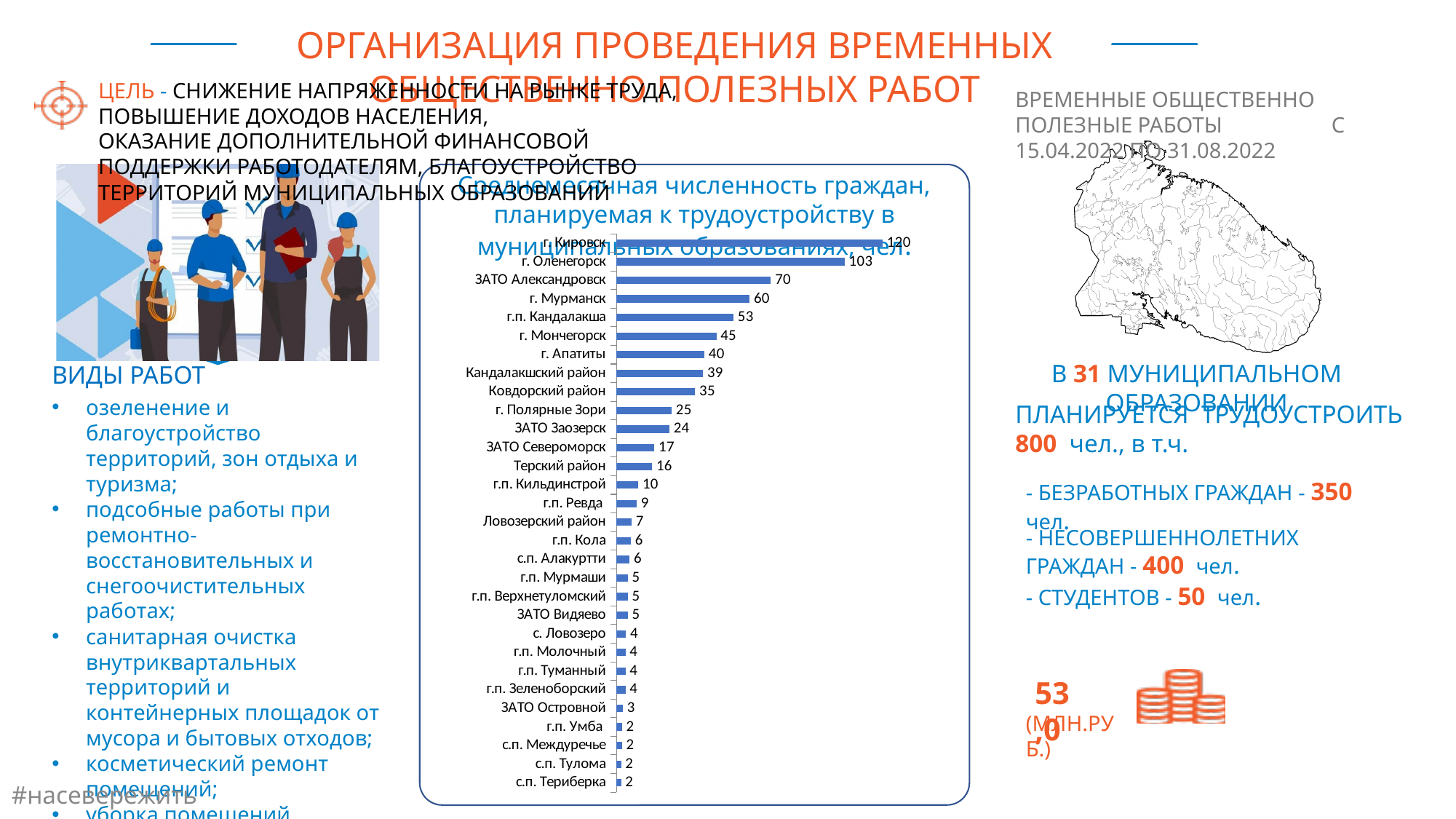
What is the difference between the values for ЗАТО Александровск and г.п. Кандалакша? 17 How many municipalities are shown in the chart? 30 What is the value for Ковдорский район? 35 Which is larger, the value for г. Мончегорск or the value for г. Апатиты? г. Мончегорск What is the value for г. Мурманск? 60 What is the value for г. Кировск? 120 Which municipality has the highest value? г. Кировск What is the difference between the values for г. Кировск and г. Оленегорск? 17 Which is larger, the value for Терский район or the value for г.п. Кильдинстрой? Терский район What is the value for ЗАТО Североморск? 17 What kind of chart is shown on the slide? bar chart What is the title of the chart? Среднемесячная численность граждан, планируемая к трудоустройству в муниципальных образованиях, чел.